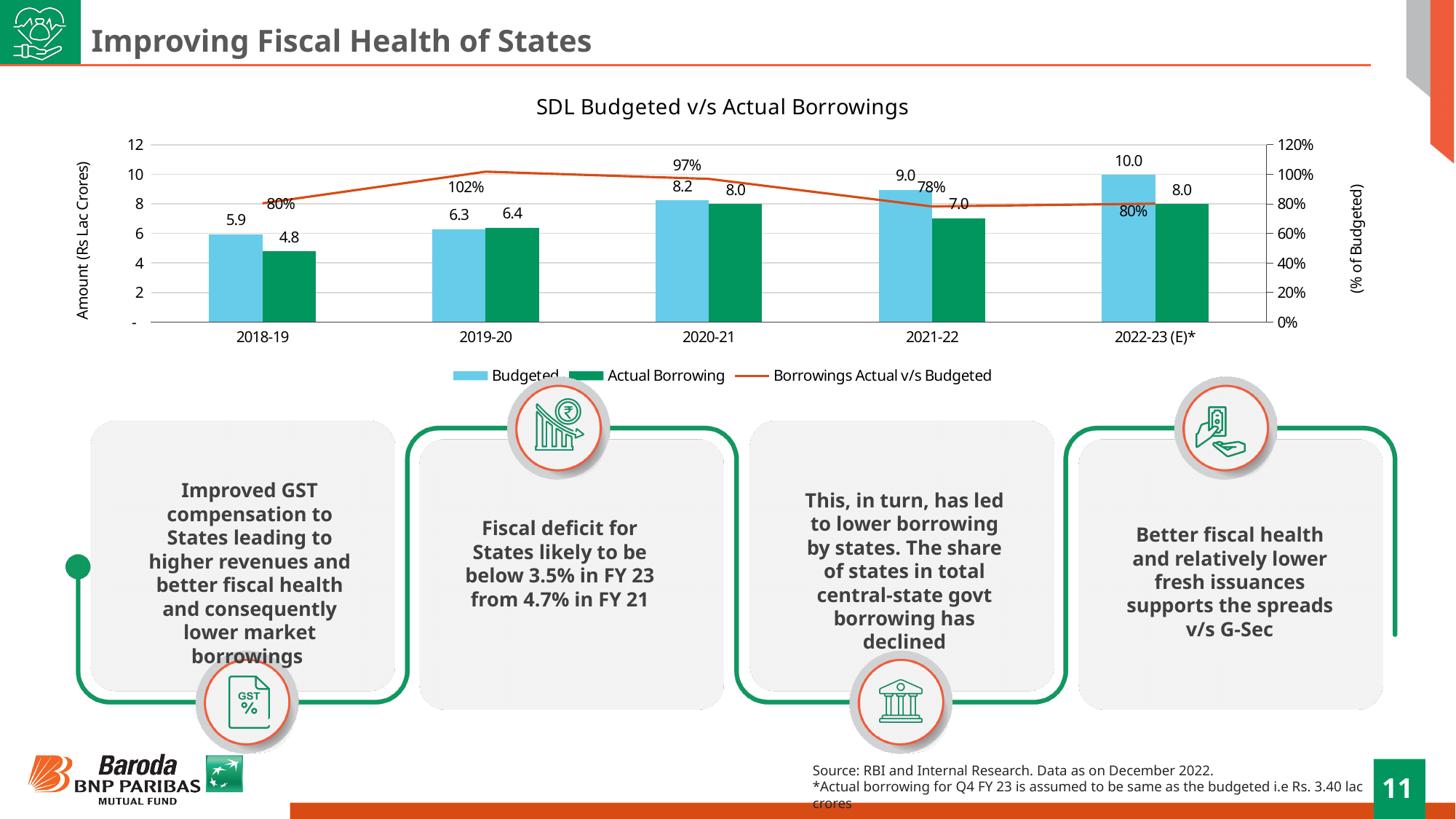
What is the Actual Borrowing value for 2018-19? 4.8 What is the difference between the Budgeted and Actual Borrowing values for 2021-22? 2.0 What is the Borrowings Actual v/s Budgeted percentage for 2019-20? 102% Which is larger for 2019-20, Budgeted or Actual Borrowing? Actual Borrowing What is the title of the chart? SDL Budgeted v/s Actual Borrowings What kind of chart is used for the Budgeted and Actual Borrowing series? Bar chart Which year has the highest Budgeted value? 2022-23 (E)* How many series does the legend list? 3 Which year has the lowest Actual Borrowing value? 2018-19 How many years are shown on the x axis? 5 Do the Budgeted values rise or fall from 2018-19 to 2022-23 (E)*? Rise What is the Budgeted value for 2020-21? 8.2